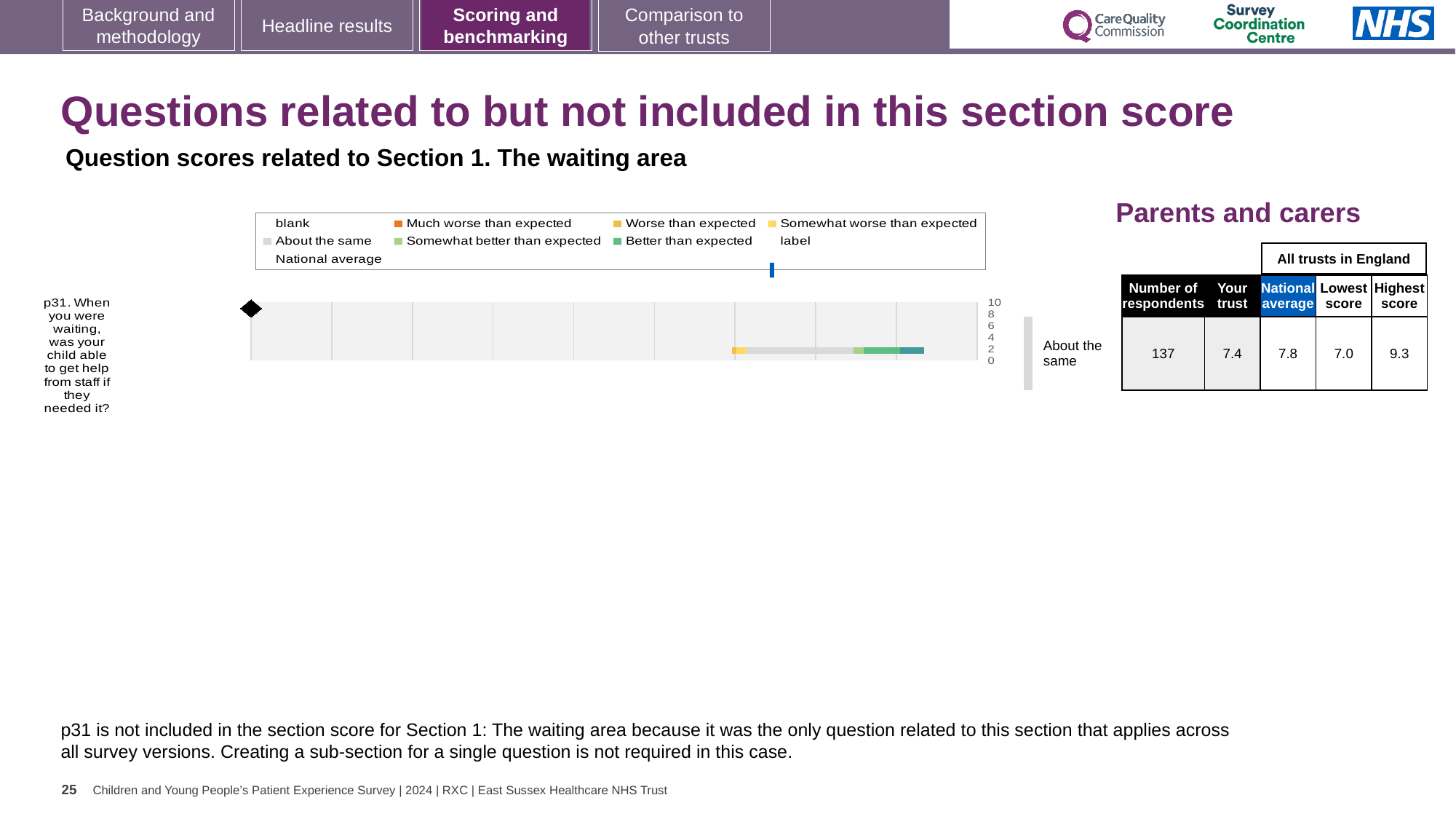
What is the national average score for p31? 7.8 What benchmark category label is shown to the right of the bar for p31? About the same How many respondents answered p31? 137 What is the lowest score across all trusts in England for p31? 7.0 How many survey questions are plotted in the chart? 1 What is the difference between the highest score and the lowest score for p31? 2.3 Which is larger for p31: the 'Your trust' score or the national average? National average What is the highest score across all trusts in England for p31? 9.3 What is the 'Your trust' score for p31 in the Parents and carers table? 7.4 By how much does the national average exceed the 'Your trust' score for p31? 0.4 What type of chart is shown on the slide for question p31? bar chart Which survey question is plotted in the chart? p31. When you were waiting, was your child able to get help from staff if they needed it?